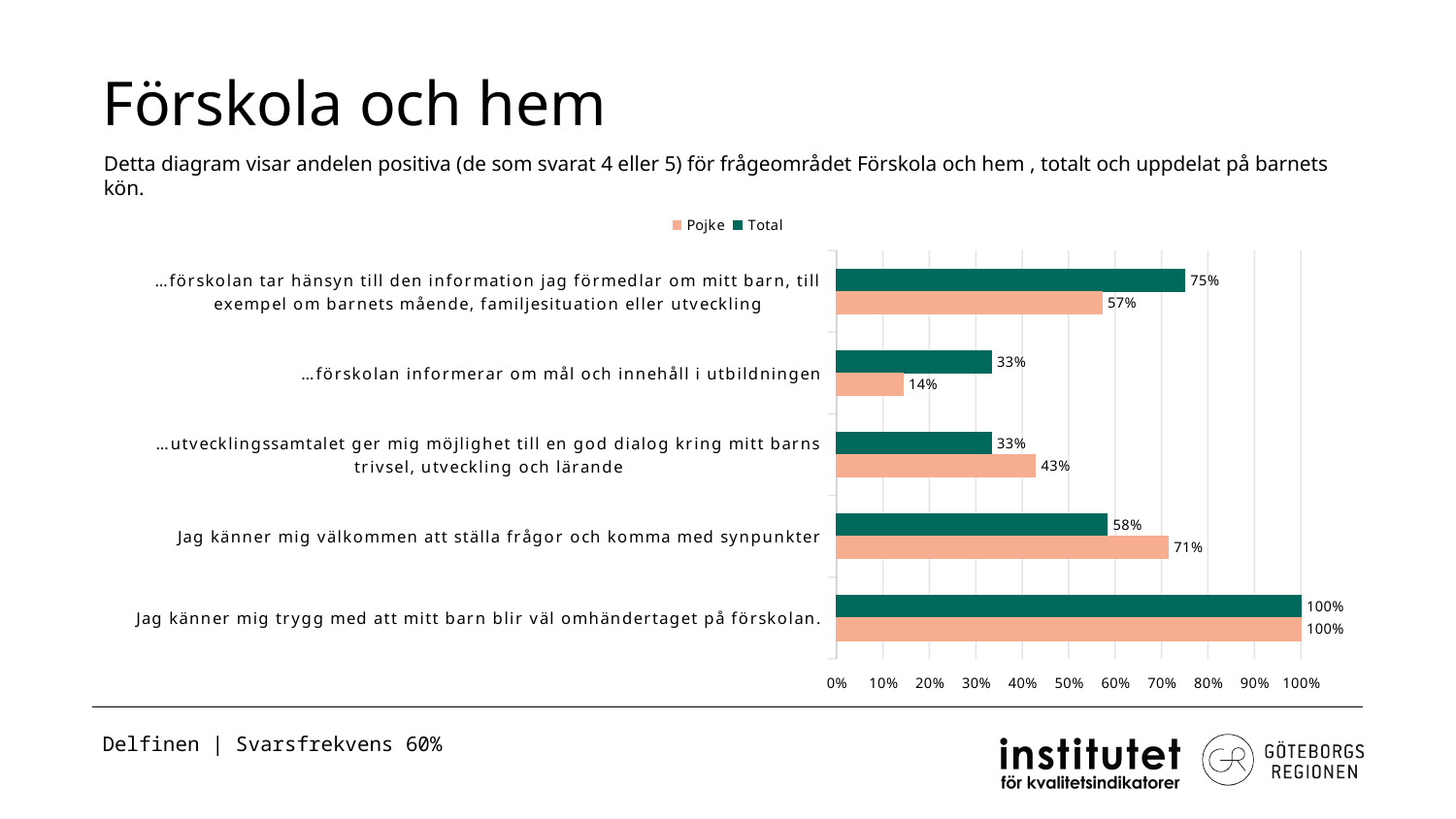
How many categories are shown in the chart? 5 What kind of chart is shown on the slide? Bar chart Which series is shown in dark green in the legend? Total What is the Pojke value for "…förskolan tar hänsyn till den information jag förmedlar om mitt barn, till exempel om barnets mående, familjesituation eller utveckling"? 57% How many series does the legend list? 2 Which category has the lowest Pojke value? …förskolan informerar om mål och innehåll i utbildningen What is the difference between the Pojke and Total values for "Jag känner mig välkommen att ställa frågor och komma med synpunkter"? 13 percentage points For "…utvecklingssamtalet ger mig möjlighet till en god dialog kring mitt barns trivsel, utveckling och lärande", which is larger, the Pojke value or the Total value? Pojke What is the Pojke value for "…förskolan informerar om mål och innehåll i utbildningen"? 14% What is the difference between the Total and Pojke values for "…förskolan tar hänsyn till den information jag förmedlar om mitt barn, till exempel om barnets mående, familjesituation eller utveckling"? 18 percentage points Which category has the highest Total value? Jag känner mig trygg med att mitt barn blir väl omhändertaget på förskolan. What is the Total value for "Jag känner mig välkommen att ställa frågor och komma med synpunkter"? 58%